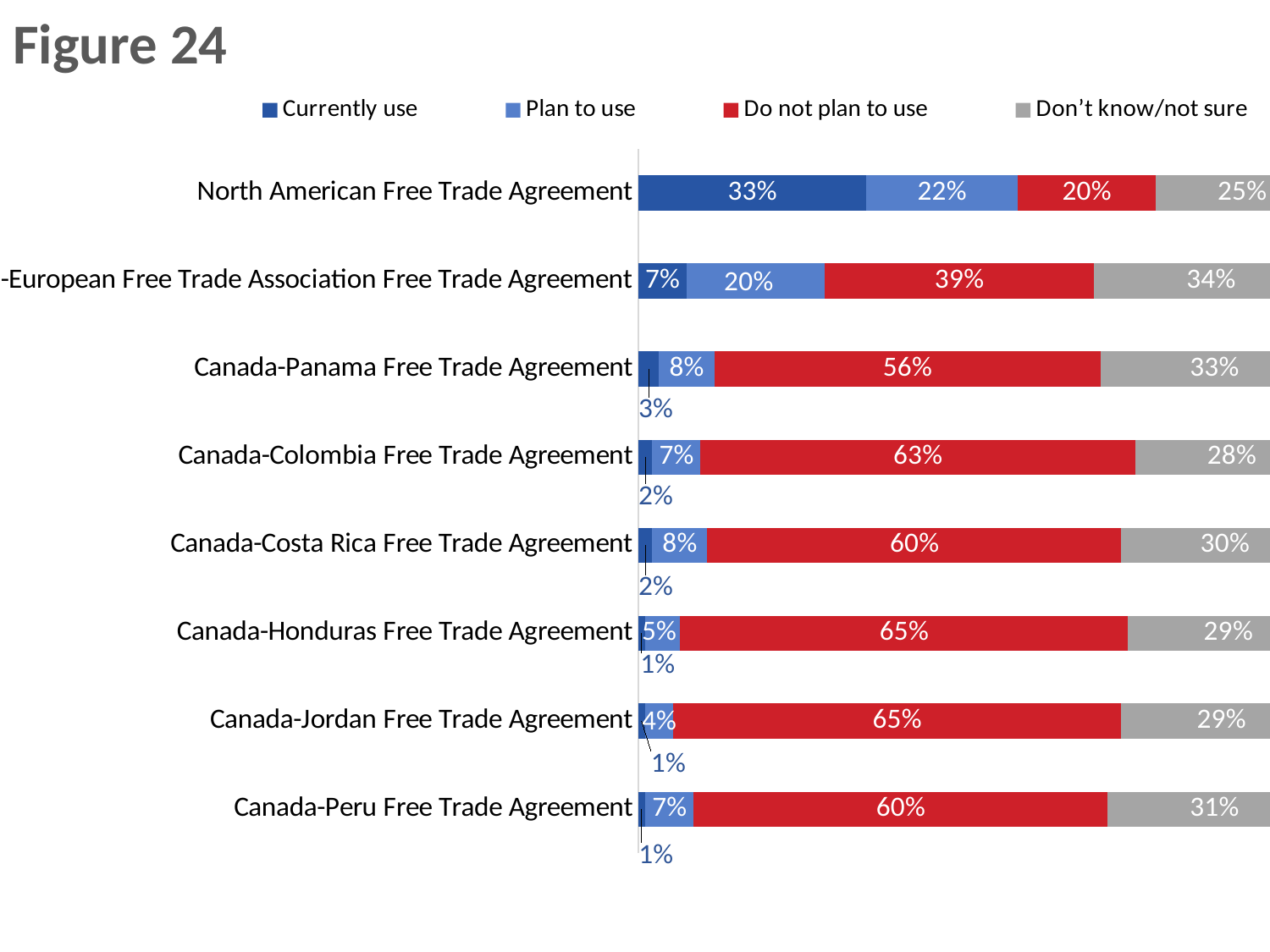
What is the total of the four segments for the North American Free Trade Agreement bar? 100% What is the 'Plan to use' value for the Canada-Jordan Free Trade Agreement? 4% What percentage of respondents currently use the North American Free Trade Agreement? 33% Which agreement has the lowest 'Do not plan to use' percentage? North American Free Trade Agreement What is the 'Do not plan to use' value for the Canada-Colombia Free Trade Agreement? 63% Which agreement has the highest 'Currently use' percentage? North American Free Trade Agreement What kind of chart is shown on the slide? Stacked bar chart How many series does the legend list? 4 How many percentage points higher is the 'Do not plan to use' value for the Canada-Honduras Free Trade Agreement than for the Canada-Panama Free Trade Agreement? 9 percentage points How many trade agreements are shown in the chart? 8 What is the title of the chart? Figure 24 Which has the larger 'Don't know/not sure' value: the Canada-Peru Free Trade Agreement or the Canada-Costa Rica Free Trade Agreement? Canada-Peru Free Trade Agreement